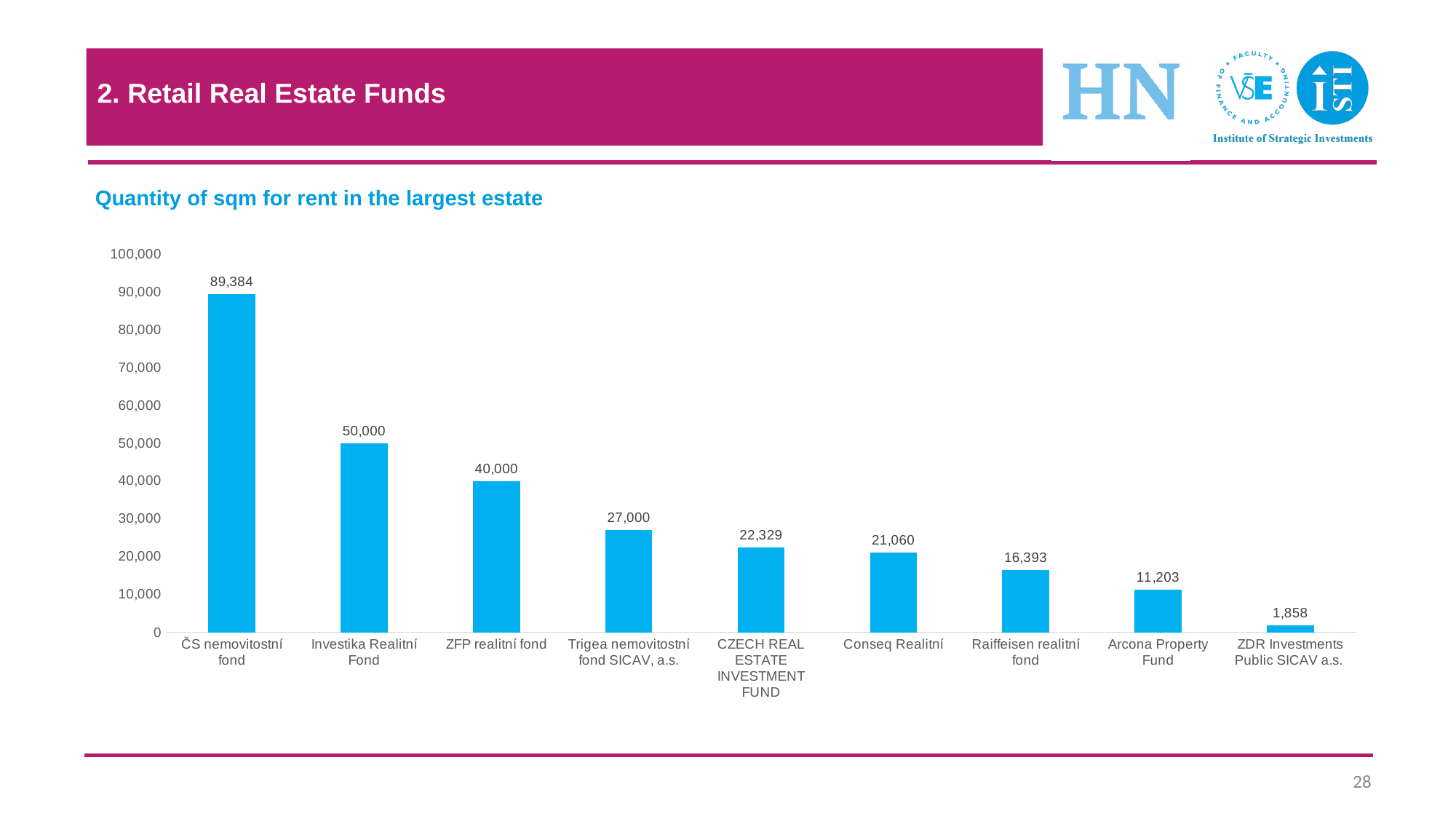
Is the value for ZFP realitní fond greater or less than 50,000? less How many funds are shown in the chart? 9 What is the quantity of sqm for rent in the largest estate for ČS nemovitostní fond? 89,384 What value is shown for Arcona Property Fund? 11,203 Which fund has the lowest quantity of sqm for rent in the largest estate? ZDR Investments Public SICAV a.s. Which is larger, the value for Trigea nemovitostní fond SICAV, a.s. or the value for Conseq Realitní? Trigea nemovitostní fond SICAV, a.s. Which fund has the highest quantity of sqm for rent in the largest estate? ČS nemovitostní fond What is the title of the chart? Quantity of sqm for rent in the largest estate What kind of chart is shown on the slide? Bar chart What is the difference between the values for CZECH REAL ESTATE INVESTMENT FUND and Conseq Realitní? 1,269 What value is shown for Raiffeisen realitní fond? 16,393 What is the difference between the values for Investika Realitní Fond and ZFP realitní fond? 10,000